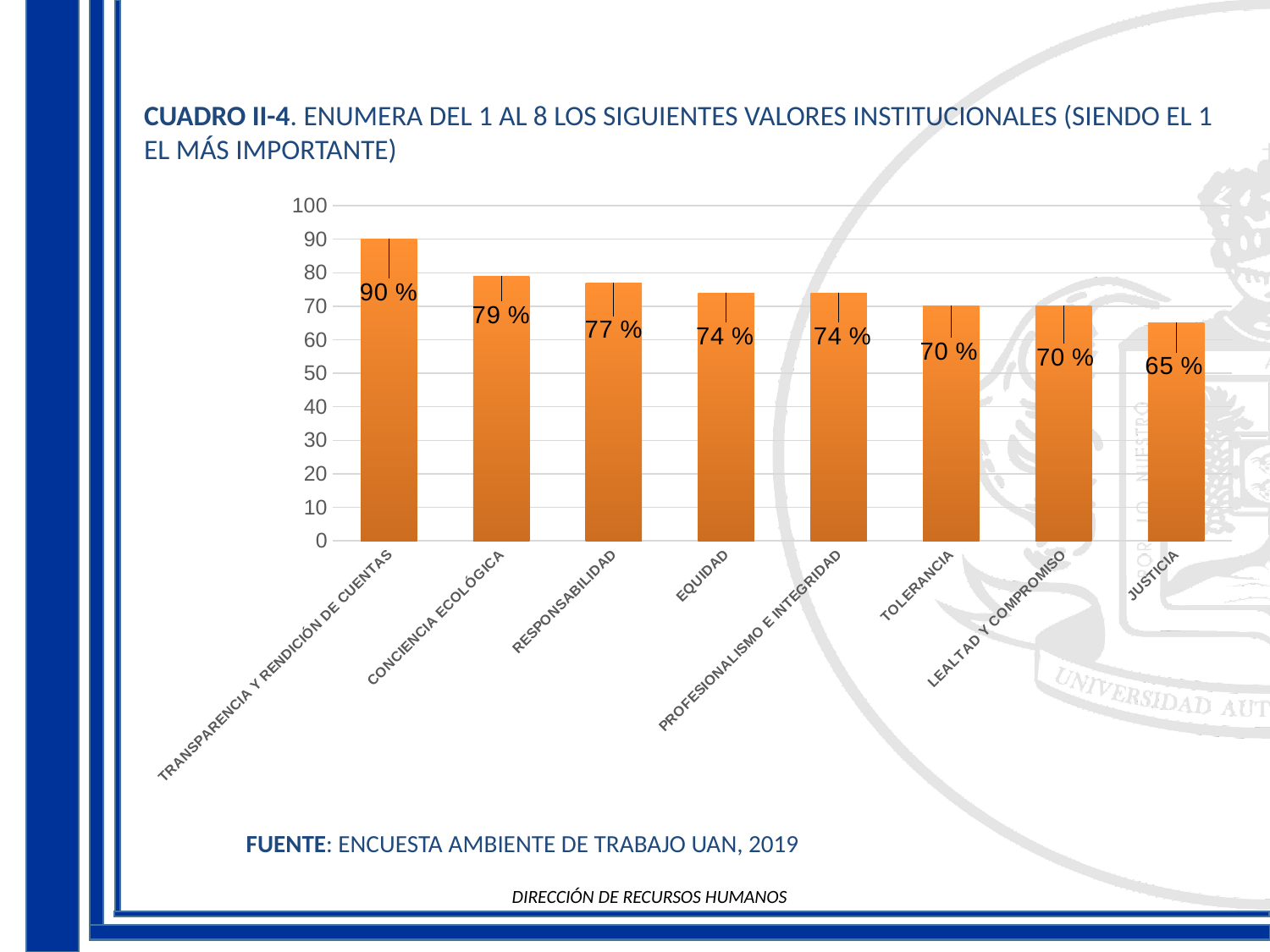
What is the value for JUSTICIA? 65 % What is the value for TOLERANCIA? 70 % How many categories are shown in the chart? 8 Which category has the lowest value? JUSTICIA Which category has the highest value? TRANSPARENCIA Y RENDICIÓN DE CUENTAS What kind of chart is shown on the slide? Bar chart What is the difference between the values for TRANSPARENCIA Y RENDICIÓN DE CUENTAS and JUSTICIA? 25 % Do the values rise or fall from left to right along the x axis? Fall What is the value for TRANSPARENCIA Y RENDICIÓN DE CUENTAS? 90 % Which is larger, the value for RESPONSABILIDAD or the value for EQUIDAD? RESPONSABILIDAD What source is cited below the chart? ENCUESTA AMBIENTE DE TRABAJO UAN, 2019 What is the value for CONCIENCIA ECOLÓGICA? 79 %